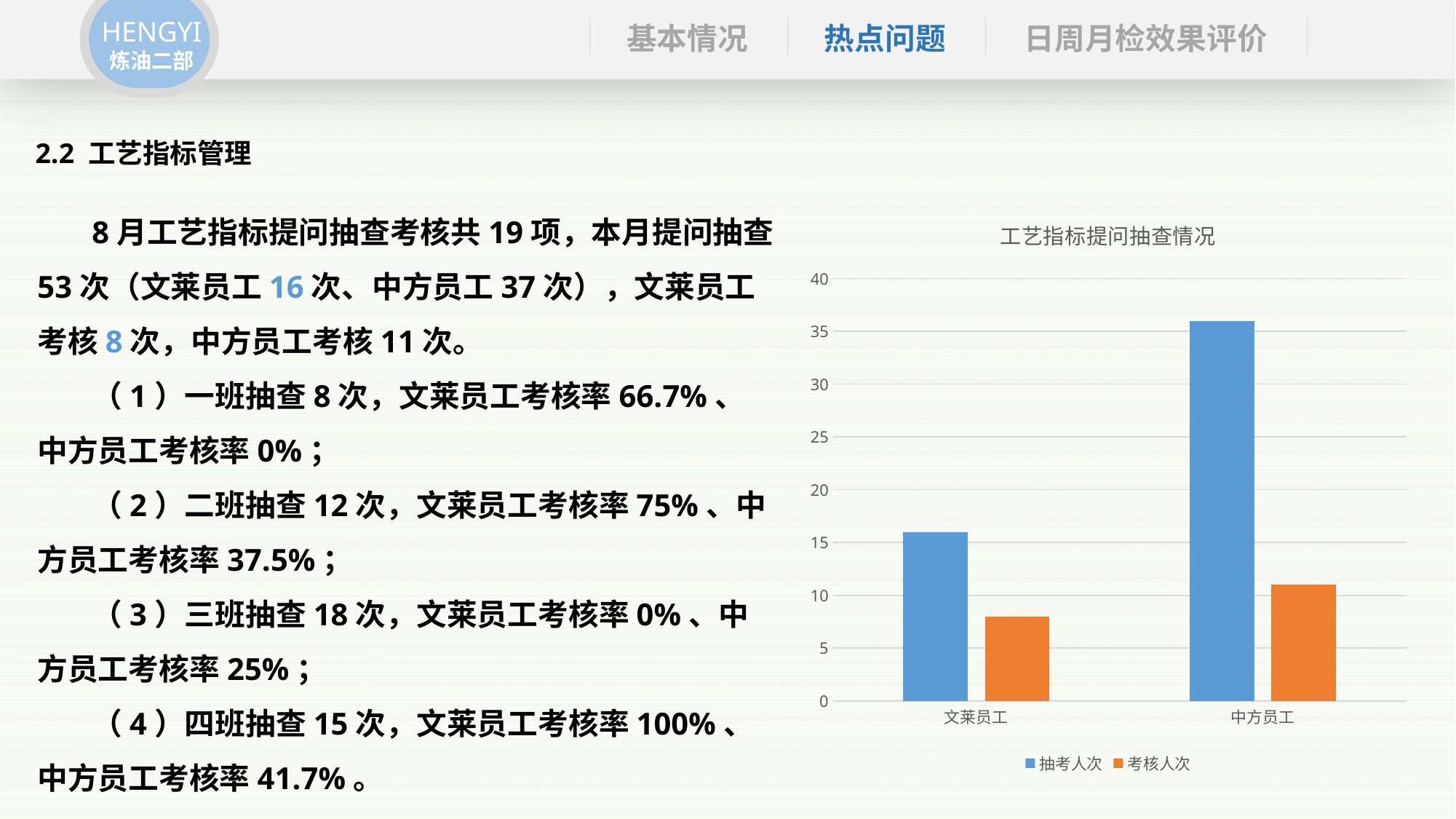
What is the title of the chart? 工艺指标提问抽查情况 Which bar in the chart is the lowest overall? 文莱员工 考核人次 What kind of chart is shown on the slide? bar chart Which is larger, the 考核人次 for 中方员工 or the 考核人次 for 文莱员工? 中方员工 Is the 考核人次 value for 中方员工 greater or less than 15? less Is the 考核人次 value for 文莱员工 greater or less than 10? less Which series is shown in orange in the chart? 考核人次 Is the 抽考人次 value for 中方员工 greater or less than 30? greater How many categories are shown on the x axis of the chart? 2 How many series does the chart legend list? 2 Which category has the highest 抽考人次 bar? 中方员工